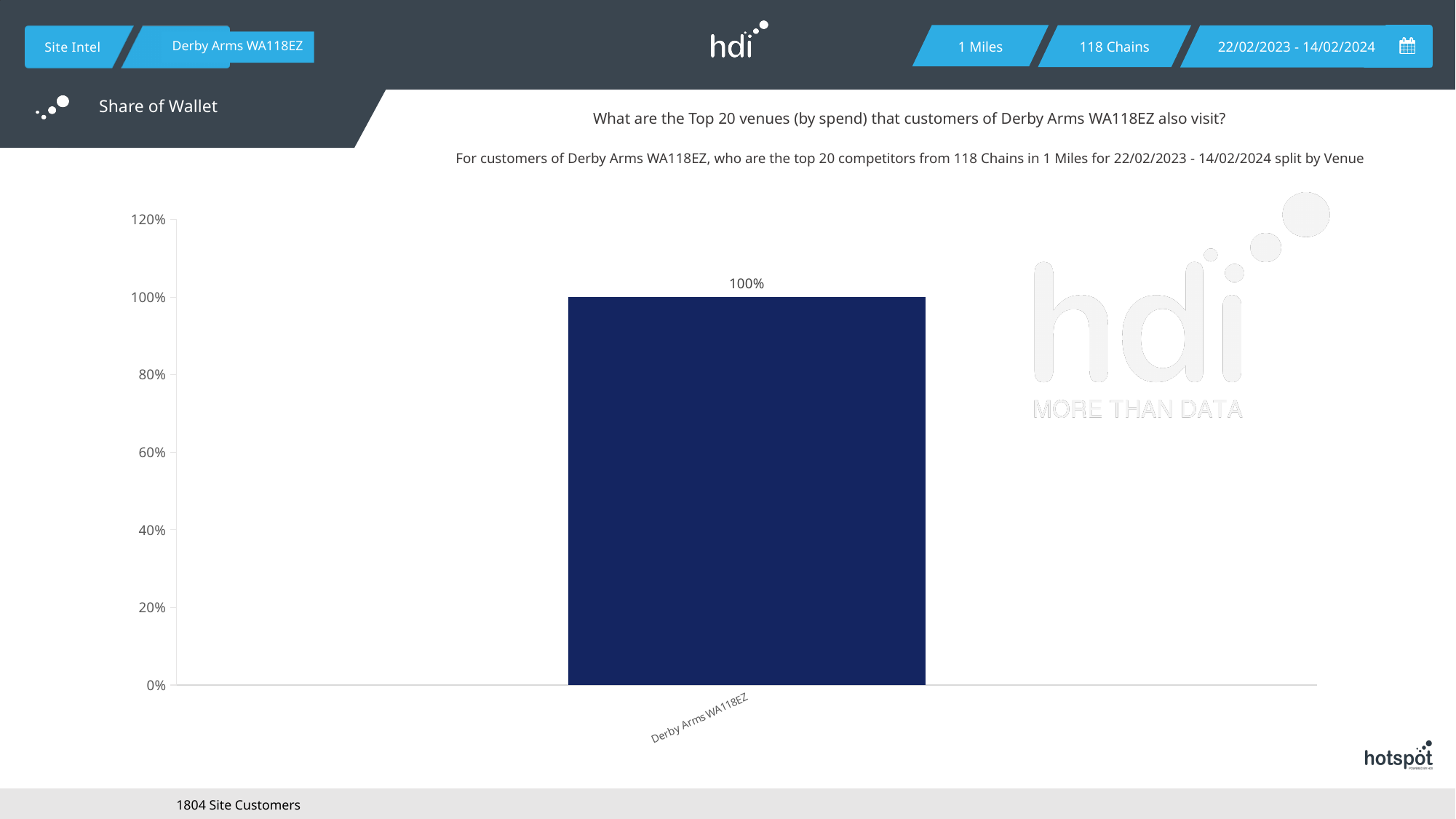
What is the value shown for Derby Arms WA118EZ? 100% What kind of chart is shown on the slide? bar chart What is the label of the only category on the x axis? Derby Arms WA118EZ How many bars are plotted in the chart? 1 What is the highest value shown on the y axis? 120% Is the value for Derby Arms WA118EZ greater or less than 120%? less Is the value for Derby Arms WA118EZ greater or less than 80%? greater How many site customers are reported at the bottom of the slide? 1804